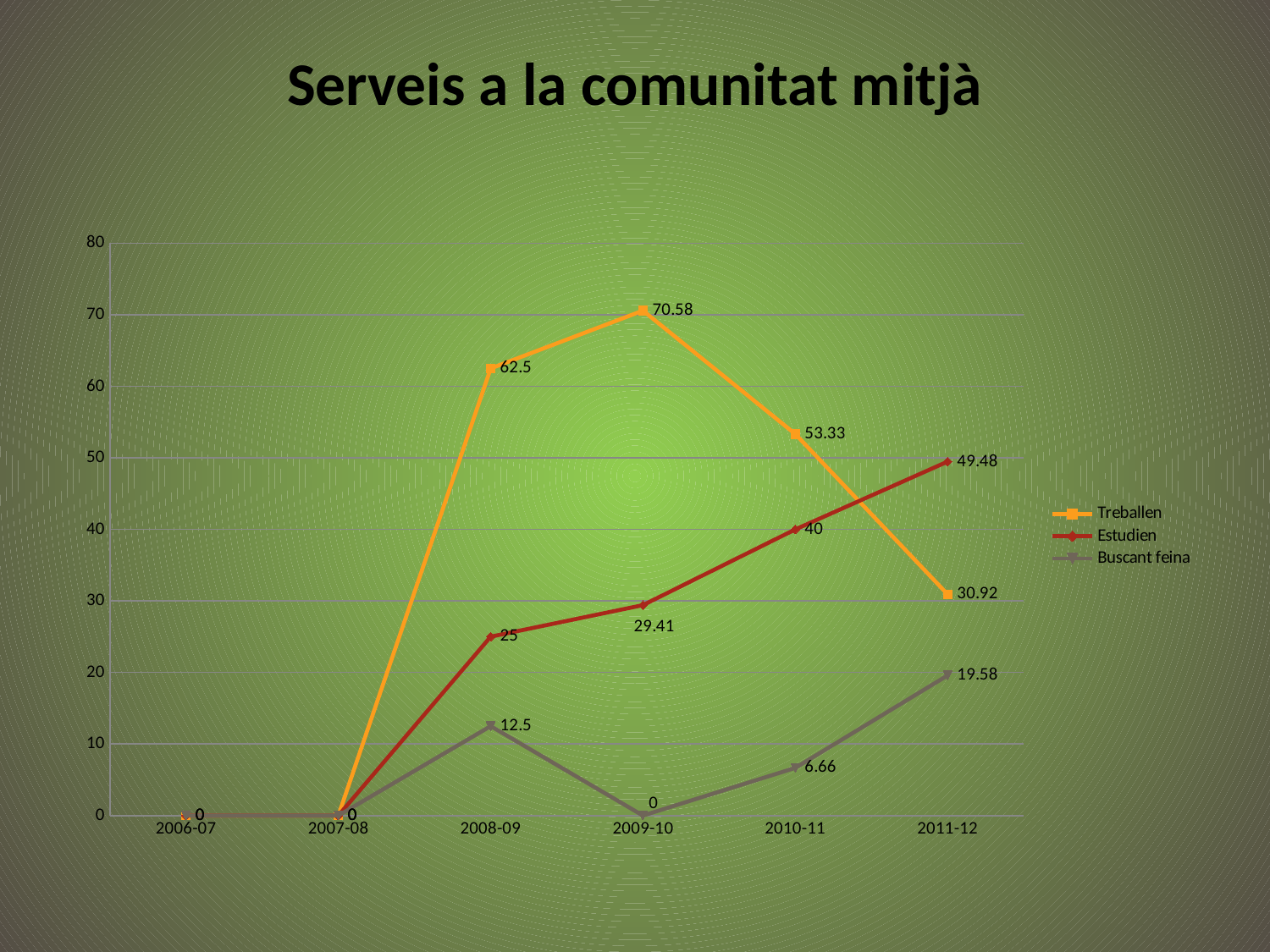
What is the value for Treballen in 2009-10? 70.58 Which series has the larger value in 2011-12, Treballen or Estudien? Estudien In which year does Treballen reach its highest value? 2009-10 Does the Treballen series rise or fall from 2009-10 to 2011-12? fall What is the difference between Treballen and Estudien in 2010-11? 13.33 What is the value for Estudien in 2011-12? 49.48 Is the value for Treballen in 2008-09 greater or less than 60? greater How many series does the legend list? 3 How many years are shown on the x axis? 6 What is the value for Buscant feina in 2010-11? 6.66 What kind of chart is shown on the slide? line chart In which year is Estudien at its highest? 2011-12